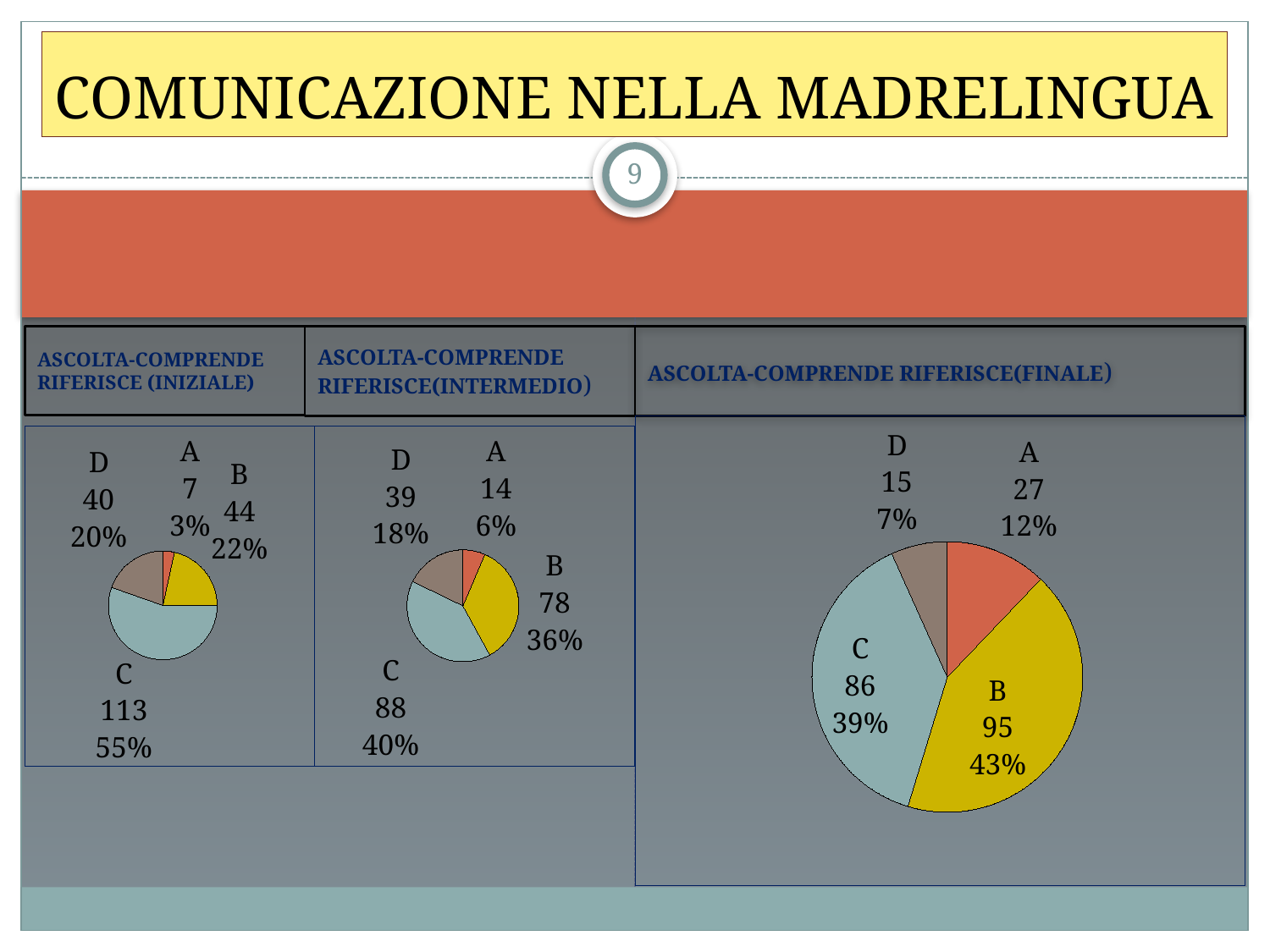
In the ASCOLTA-COMPRENDE RIFERISCE (INIZIALE) chart, what share of the pie does A represent? 3% What kind of chart is the ASCOLTA-COMPRENDE RIFERISCE (FINALE) chart? Pie chart In the ASCOLTA-COMPRENDE RIFERISCE (INIZIALE) chart, what is the value for C? 113 In the ASCOLTA-COMPRENDE RIFERISCE (INTERMEDIO) chart, which category has the lowest value? A In the ASCOLTA-COMPRENDE RIFERISCE (FINALE) chart, what is the value for D? 15 In the ASCOLTA-COMPRENDE RIFERISCE (FINALE) chart, what is the difference between the values for B and C? 9 In the ASCOLTA-COMPRENDE RIFERISCE (FINALE) chart, which category has the highest value? B In the ASCOLTA-COMPRENDE RIFERISCE (INTERMEDIO) chart, what is the value for B? 78 In the ASCOLTA-COMPRENDE RIFERISCE (INIZIALE) chart, which is larger, the value for B or the value for D? B In the ASCOLTA-COMPRENDE RIFERISCE (FINALE) chart, what share of the pie does C represent? 39% How many categories does the ASCOLTA-COMPRENDE RIFERISCE (INTERMEDIO) chart show? 4 In the ASCOLTA-COMPRENDE RIFERISCE (INTERMEDIO) chart, what is the difference between the values for C and D? 49